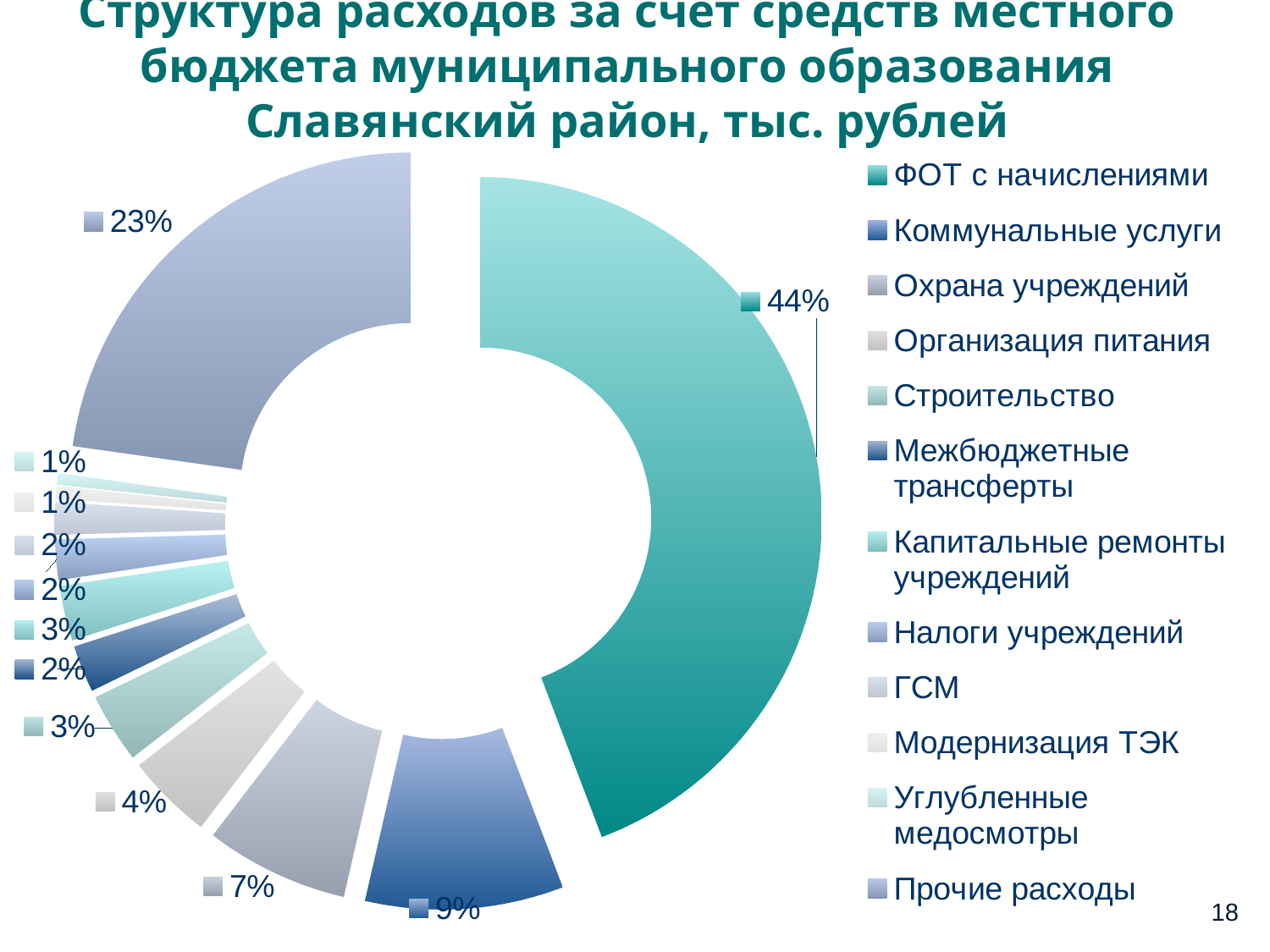
What is the difference in percentage points between ФОТ с начислениями and Прочие расходы? 21 What percentage is shown for Охрана учреждений? 7% Which category has the largest share of the chart? ФОТ с начислениями What kind of chart is shown on the slide? doughnut chart Which is larger, the share for Коммунальные услуги or the share for Охрана учреждений? Коммунальные услуги What is the title of the chart? Структура расходов за счет средств местного бюджета муниципального образования Славянский район, тыс. рублей What is the combined share of Коммунальные услуги and Охрана учреждений? 16% What percentage is shown for Прочие расходы? 23% What percentage is shown for Коммунальные услуги? 9% What share of expenditure is labelled for ФОТ с начислениями? 44% How many categories does the legend list? 12 What percentage is shown for Организация питания? 4%